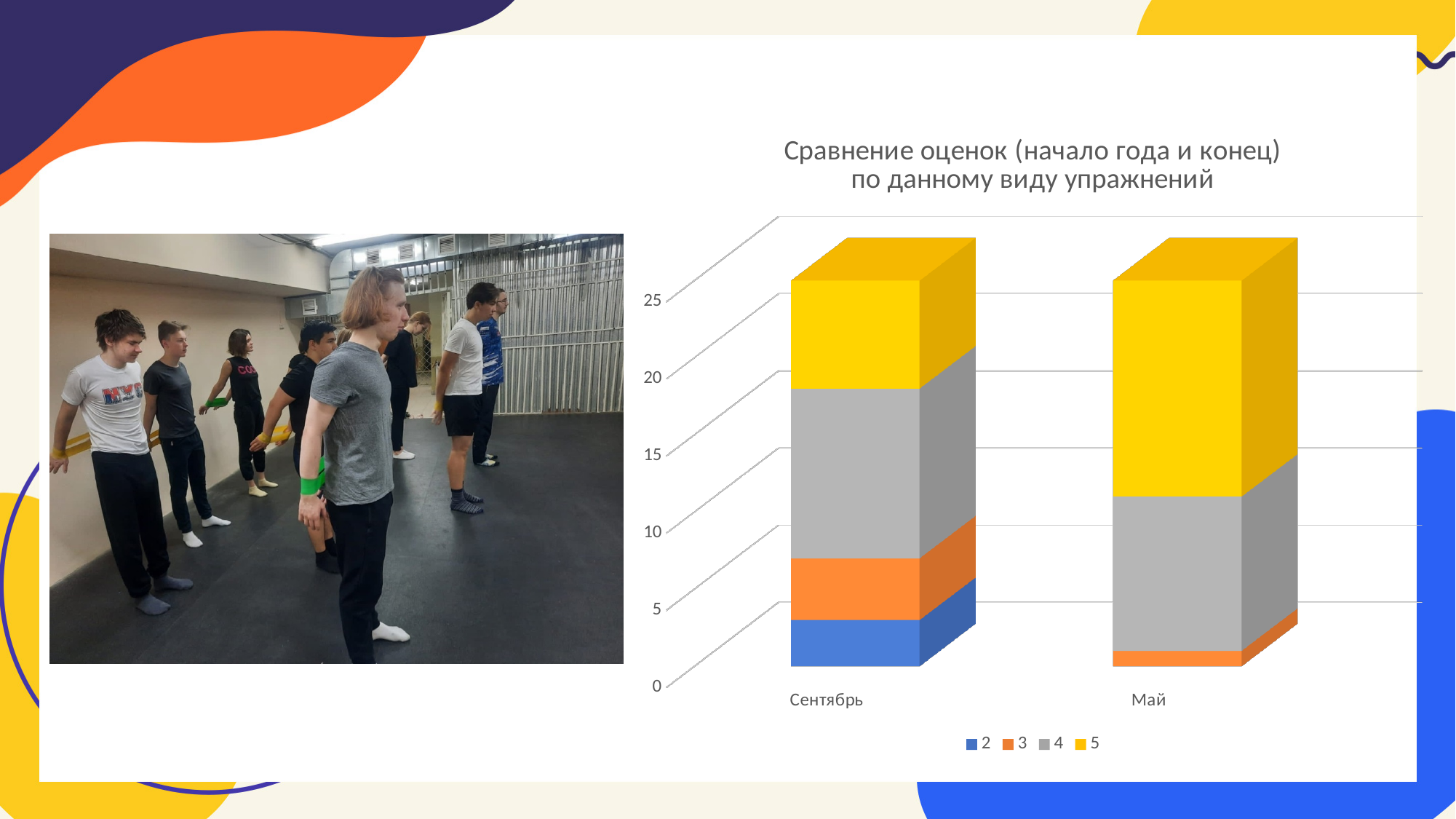
Is the value for series 5 in Май greater or less than 10? greater How many series does the chart legend list? 4 Which category has the larger value for series 3, Сентябрь or Май? Сентябрь What is the title of the chart? Сравнение оценок (начало года и конец) по данному виду упражнений Is the total height of the Май stacked bar greater or less than 20? greater Which category has the larger value for series 2, Сентябрь or Май? Сентябрь What kind of chart is shown on the slide? Stacked bar chart How many categories are shown on the x axis of the chart? 2 Is the value for series 3 in Май greater or less than 5? less Which category has the larger value for series 5, Сентябрь or Май? Май What are the two categories on the x axis of the chart? Сентябрь and Май